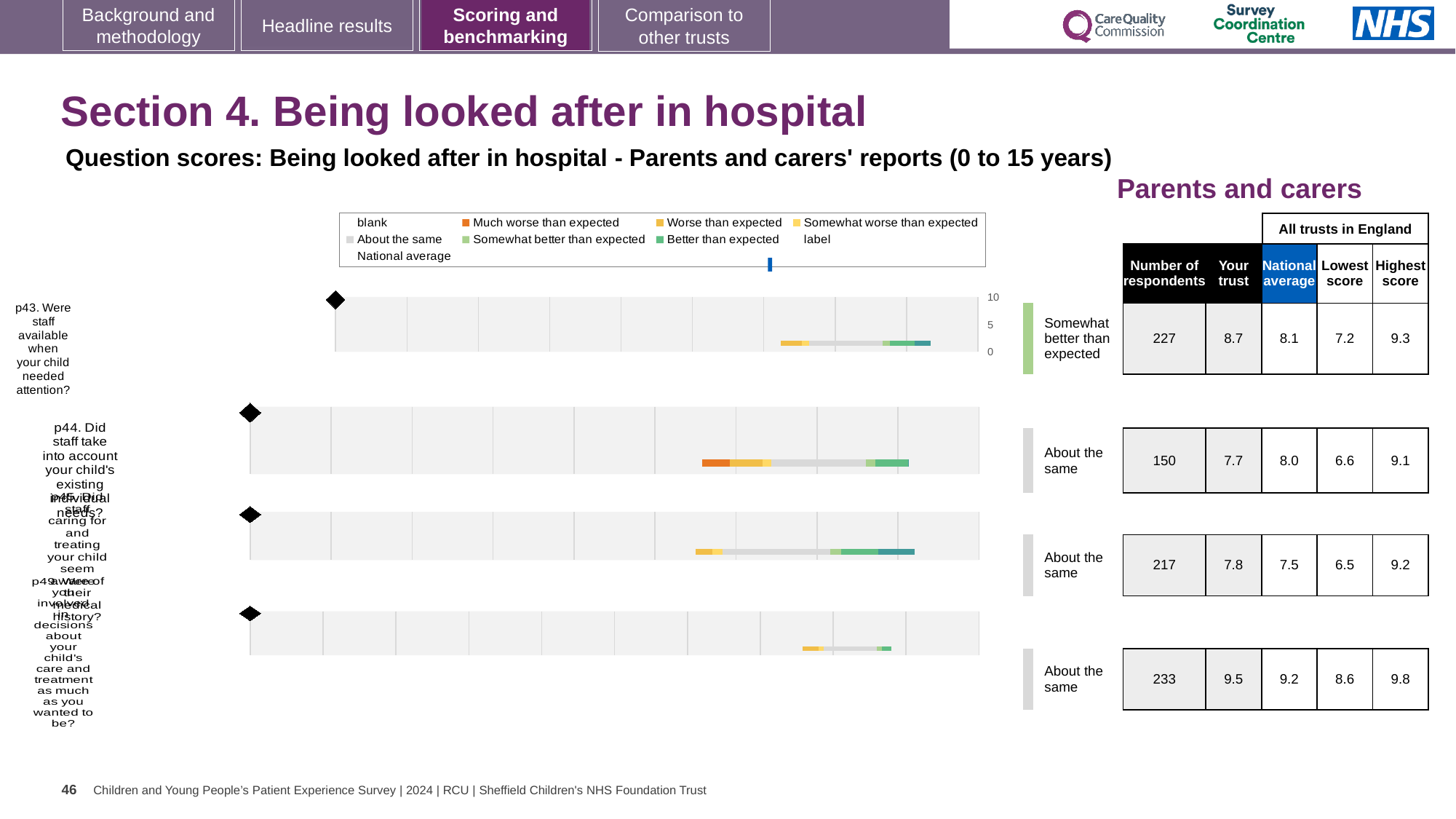
For the first chart (p43), what is the difference between the 'Your trust' score and the national average? 0.6 For the first chart (p43), what is the highest score among all trusts in England? 9.3 For the first chart (p43), what is the number of respondents? 227 For the first chart (p43), what is the national average score? 8.1 What benchmark category is shown next to the first chart (p43)? Somewhat better than expected Which of the four charts has the highest 'Your trust' score? the fourth (bottom) chart, 9.5 For the second chart (p44), what is the number of respondents? 150 What kind of chart is used for the question scores on this slide? bar chart For the first chart (p43), which is larger: the 'Your trust' score or the national average? Your trust How many question score charts are shown on the slide? 4 For the first chart (p43), what is the lowest score among all trusts in England? 7.2 For the first chart (p43, Were staff available when your child needed attention?), what is the 'Your trust' score? 8.7